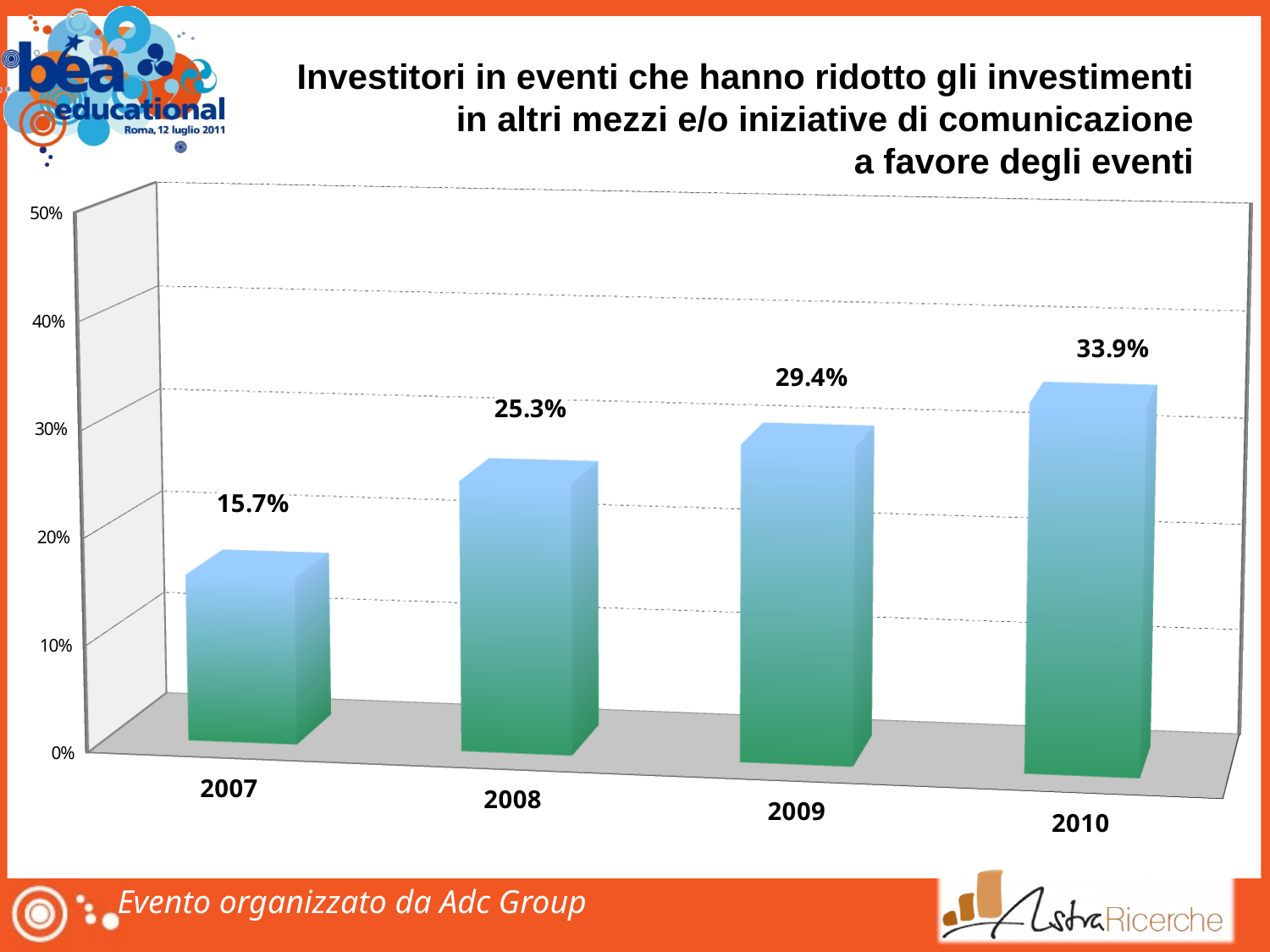
What kind of chart is shown on the slide? Bar chart What is the difference between the values for 2010 and 2007? 18.2% What is the value for 2010? 33.9% Which is larger, the value for 2008 or the value for 2009? 2009 What is the difference between the values for 2009 and 2008? 4.1% What is the value for 2009? 29.4% Which year has the highest value? 2010 How many years are shown on the chart? 4 What is the value for 2008? 25.3% What is the value for 2007? 15.7% Which year has the lowest value? 2007 Do the values rise or fall from 2007 to 2010? Rise